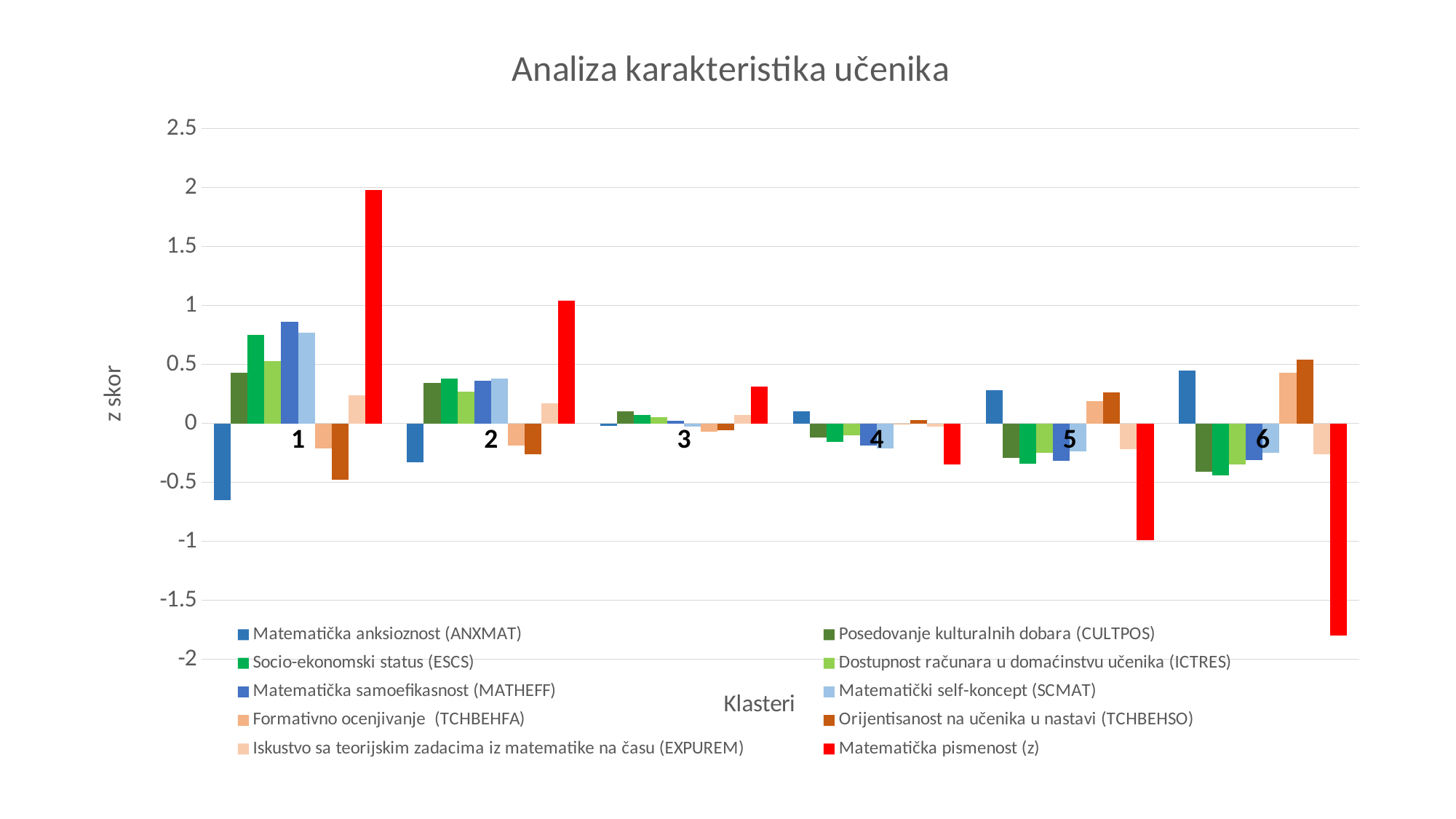
Does the value of Matematička pismenost (z) rise or fall from cluster 1 to cluster 6? fall What kind of chart is shown on the slide? bar chart How many series does the legend list? 10 Is the value of Matematička pismenost (z) for cluster 1 greater or less than 1.5? greater Which cluster has the highest value for Matematička pismenost (z)? 1 Is the value of Matematička pismenost (z) for cluster 2 greater or less than 0.5? greater Is the value of Matematička pismenost (z) for cluster 6 greater or less than -1.5? less How many clusters are shown on the x axis? 6 What is the title of the vertical axis? z skor Which cluster has the lowest value for Matematička pismenost (z)? 6 Which cluster has the larger value for Matematička anksioznost (ANXMAT), cluster 1 or cluster 6? 6